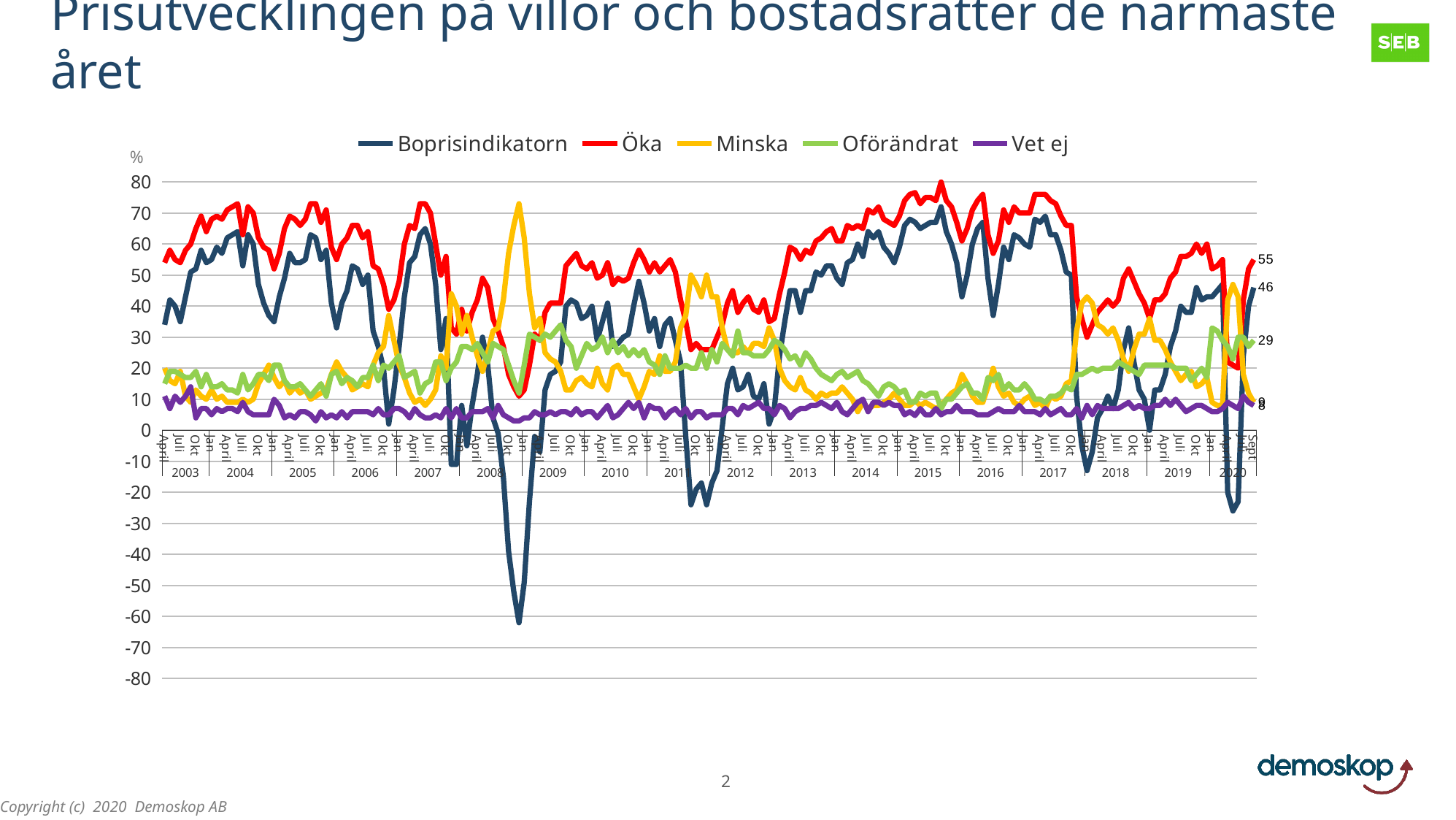
How many series does the legend list? 5 What kind of chart is shown on the slide? line chart At the end of the chart, which is larger: the Öka value or the Oförändrat value? Öka Is the peak of the Öka series around 2015 greater or less than 70? greater Is the lowest point of Boprisindikatorn, around early 2009, greater or less than -50? less What is the latest (Sept 2020) value labelled for the Oförändrat series? 29 At the end of the chart, how much higher is Öka (55) than Boprisindikatorn (46)? 9 Which series has the highest value at the end of the chart (Sept 2020)? Öka What is the latest (Sept 2020) value labelled for Boprisindikatorn? 46 What is the latest (Sept 2020) value labelled for the Öka series? 55 Is the value for Vet ej in 2015 greater or less than 20? less What colour is the Öka line in the legend? red